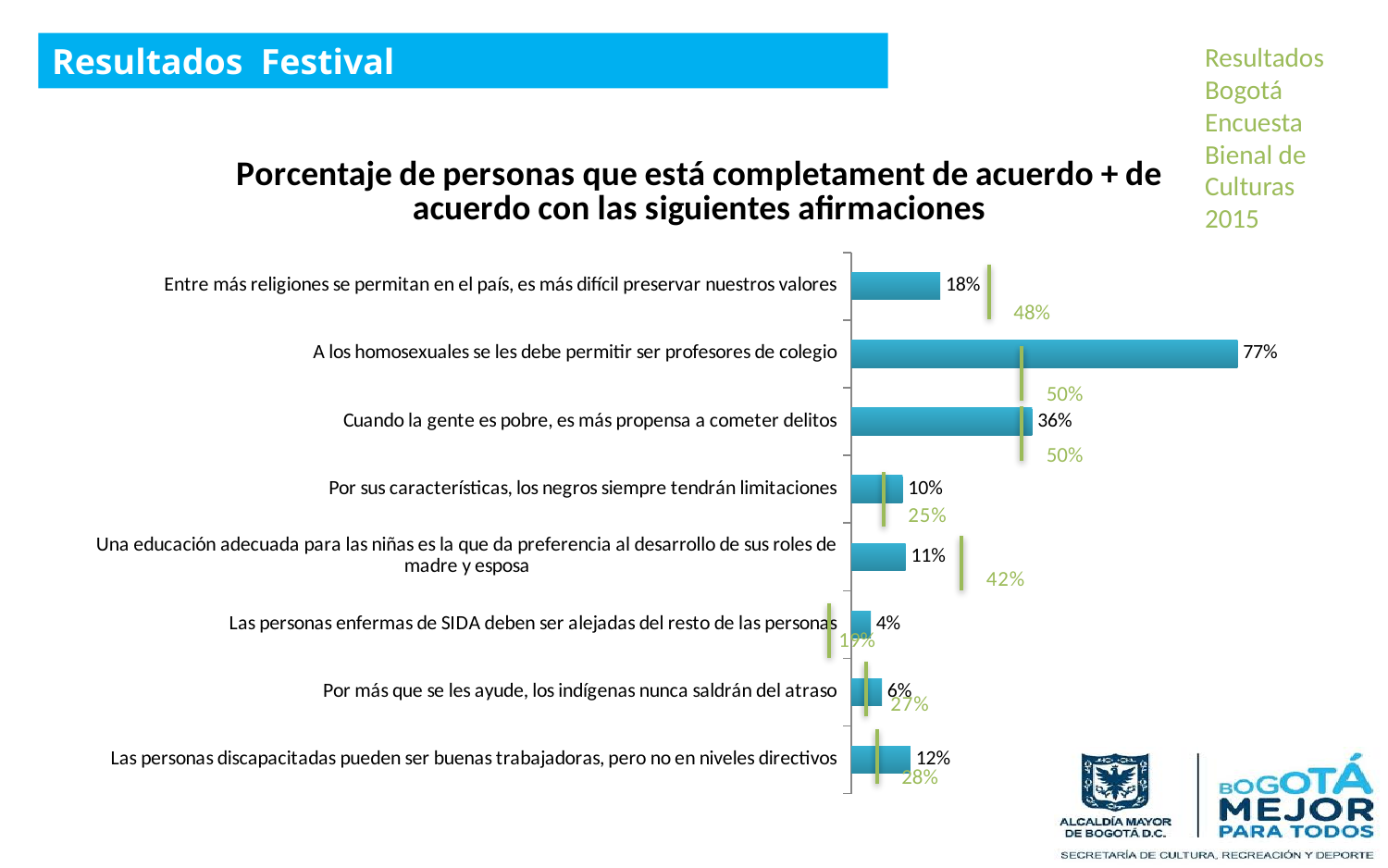
What is the value of the blue bar for "A los homosexuales se les debe permitir ser profesores de colegio"? 77% What is the value of the blue bar for "Las personas enfermas de SIDA deben ser alejadas del resto de las personas"? 4% What is the value of the blue bar for "Cuando la gente es pobre, es más propensa a cometer delitos"? 36% Which blue bar is larger: "Por sus características, los negros siempre tendrán limitaciones" or "Las personas discapacitadas pueden ser buenas trabajadoras, pero no en niveles directivos"? Las personas discapacitadas pueden ser buenas trabajadoras, pero no en niveles directivos What is the difference between the green value (48%) and the blue bar value (18%) for "Entre más religiones se permitan en el país, es más difícil preservar nuestros valores"? 30% What green (Bogotá) value is shown next to "Una educación adecuada para las niñas es la que da preferencia al desarrollo de sus roles de madre y esposa"? 42% How many statements (categories) are shown in the chart? 8 Which statement has the lowest blue bar value? Las personas enfermas de SIDA deben ser alejadas del resto de las personas What is the difference between the blue bar values for "A los homosexuales se les debe permitir ser profesores de colegio" and "Cuando la gente es pobre, es más propensa a cometer delitos"? 41% What green (Bogotá) value is shown next to "Entre más religiones se permitan en el país, es más difícil preservar nuestros valores"? 48% Which statement has the highest blue bar value? A los homosexuales se les debe permitir ser profesores de colegio What type of chart is shown on the slide? Bar chart